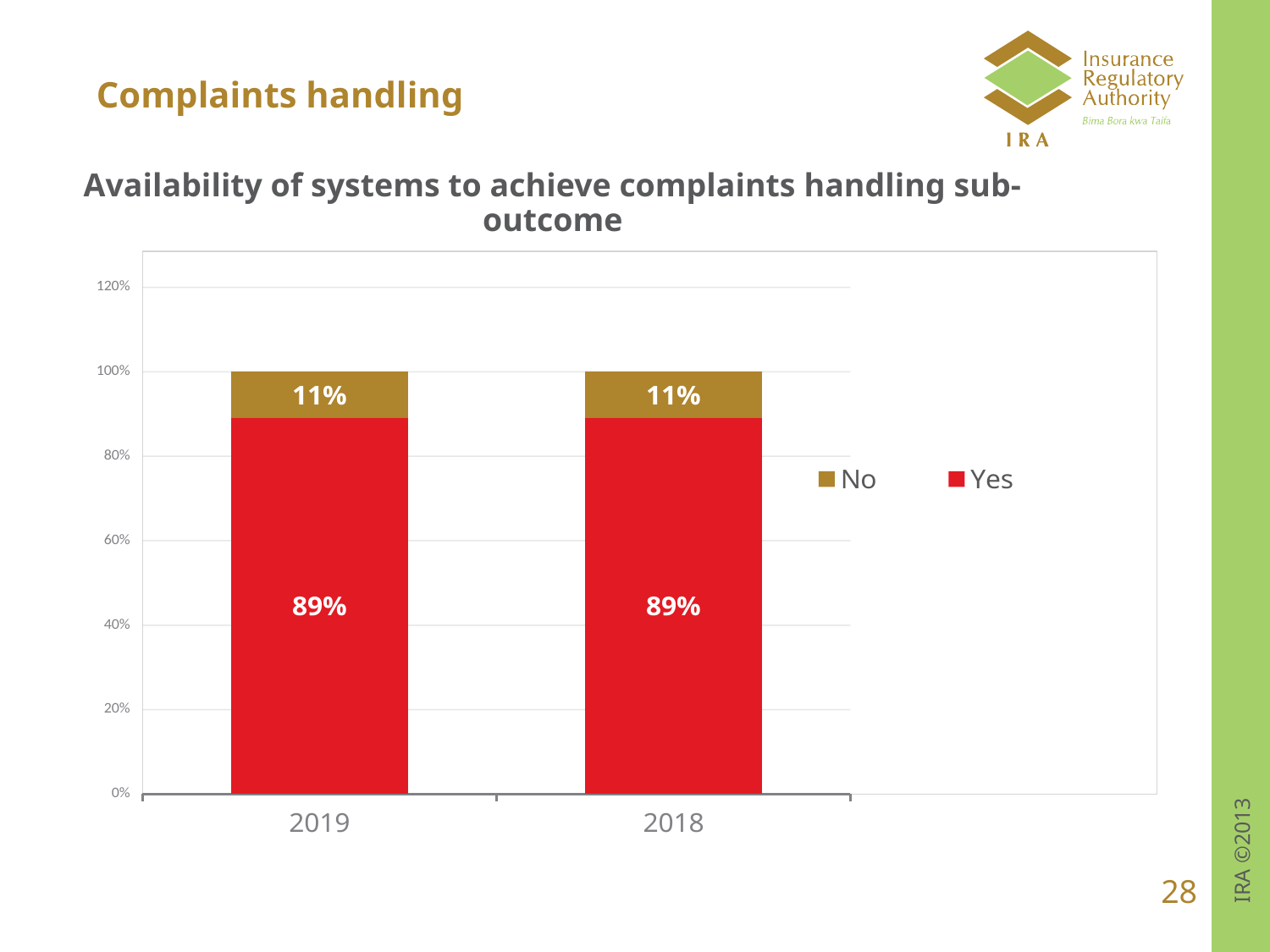
How many years are shown on the x axis? 2 What is the value for Yes in 2018? 89% What is the difference between the Yes and No values in 2019? 78% Which is larger in 2018, Yes or No? Yes How many series does the legend list? 2 What is the value for Yes in 2019? 89% What is the value for No in 2019? 11% What is the title of the chart? Availability of systems to achieve complaints handling sub-outcome Which colour represents the Yes series? Red What is the value for No in 2018? 11% What is the total of the stacked bar for 2019? 100% What kind of chart is shown? Stacked bar chart